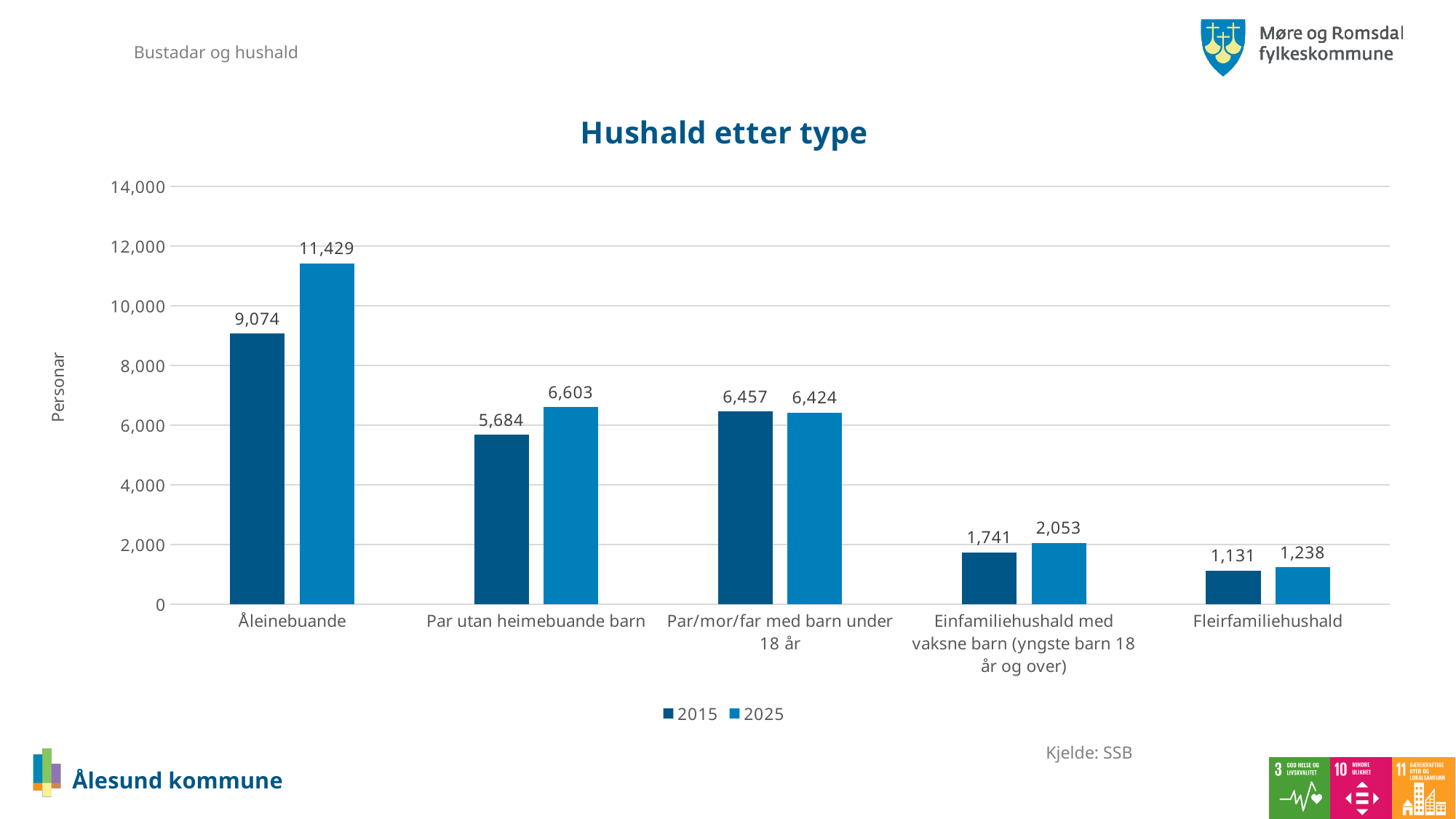
How many series does the legend list? 2 How many household type categories are shown on the x axis? 5 What is the difference between the 2025 and 2015 values for Åleinebuande? 2,355 Is the 2015 value for Einfamiliehushald med vaksne barn (yngste barn 18 år og over) greater or less than 2,000? less What is the value for Par utan heimebuande barn in 2015? 5,684 What is the title of the chart? Hushald etter type Which category has the highest value in 2015? Åleinebuande Which is larger for Par/mor/far med barn under 18 år: the 2015 value or the 2025 value? 2015 What is the value for Åleinebuande in 2025? 11,429 What is the value for Fleirfamiliehushald in 2025? 1,238 What kind of chart is shown on the slide? bar chart Which category has the lowest value in 2025? Fleirfamiliehushald